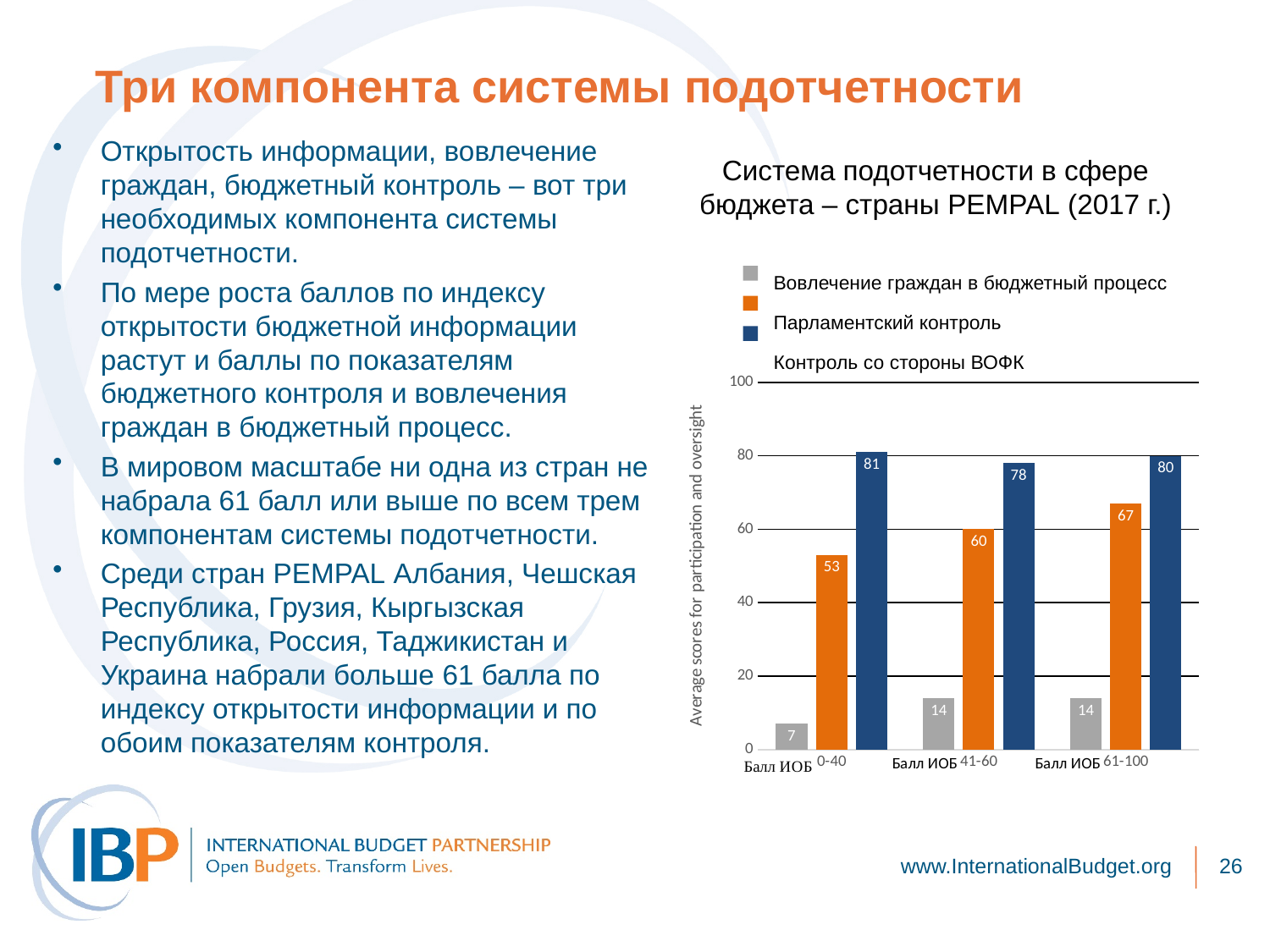
What is the difference between Парламентский контроль in Балл ИОБ 61-100 and in Балл ИОБ 0-40? 14 How many categories are shown on the x axis? 3 Which category has the lowest value for Вовлечение граждан в бюджетный процесс? Балл ИОБ 0-40 What is the value for Вовлечение граждан в бюджетный процесс in the Балл ИОБ 61-100 category? 14 What is the value for Парламентский контроль in the Балл ИОБ 0-40 category? 53 Which category has the highest value for Парламентский контроль? Балл ИОБ 61-100 Is the value for Парламентский контроль in Балл ИОБ 41-60 greater or less than 40? greater What is the value for Контроль со стороны ВОФК in the Балл ИОБ 41-60 category? 78 Do the values for Парламентский контроль rise or fall from Балл ИОБ 0-40 to Балл ИОБ 61-100? rise How many series does the legend list? 3 Which is larger: Контроль со стороны ВОФК in Балл ИОБ 0-40 or in Балл ИОБ 41-60? Балл ИОБ 0-40 What kind of chart is shown on the slide? bar chart